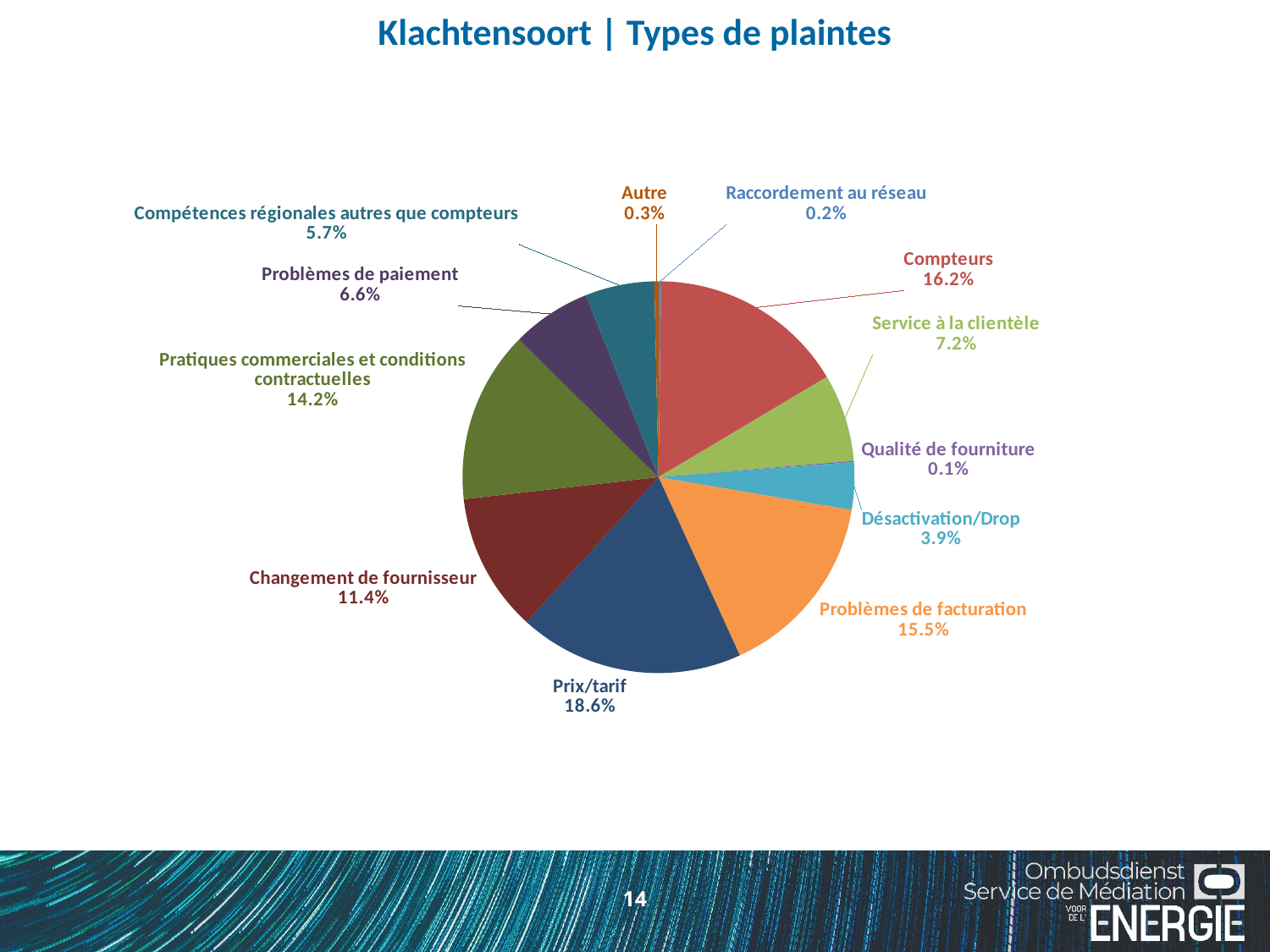
Which is larger, Pratiques commerciales et conditions contractuelles or Changement de fournisseur? Pratiques commerciales et conditions contractuelles What is the value shown for Compteurs? 16.2% What is the title of the chart? Klachtensoort | Types de plaintes What is the value shown for Désactivation/Drop? 3.9% How many categories are shown in the pie chart? 12 Which category has the smallest share of the pie? Qualité de fourniture What is the difference between Compteurs and Service à la clientèle? 9.0% What share of complaints is Prix/tarif? 18.6% What is the difference between Problèmes de facturation and Problèmes de paiement? 8.9% Which category has the largest share of the pie? Prix/tarif What type of chart is shown on the slide? pie chart What is the value shown for Changement de fournisseur? 11.4%